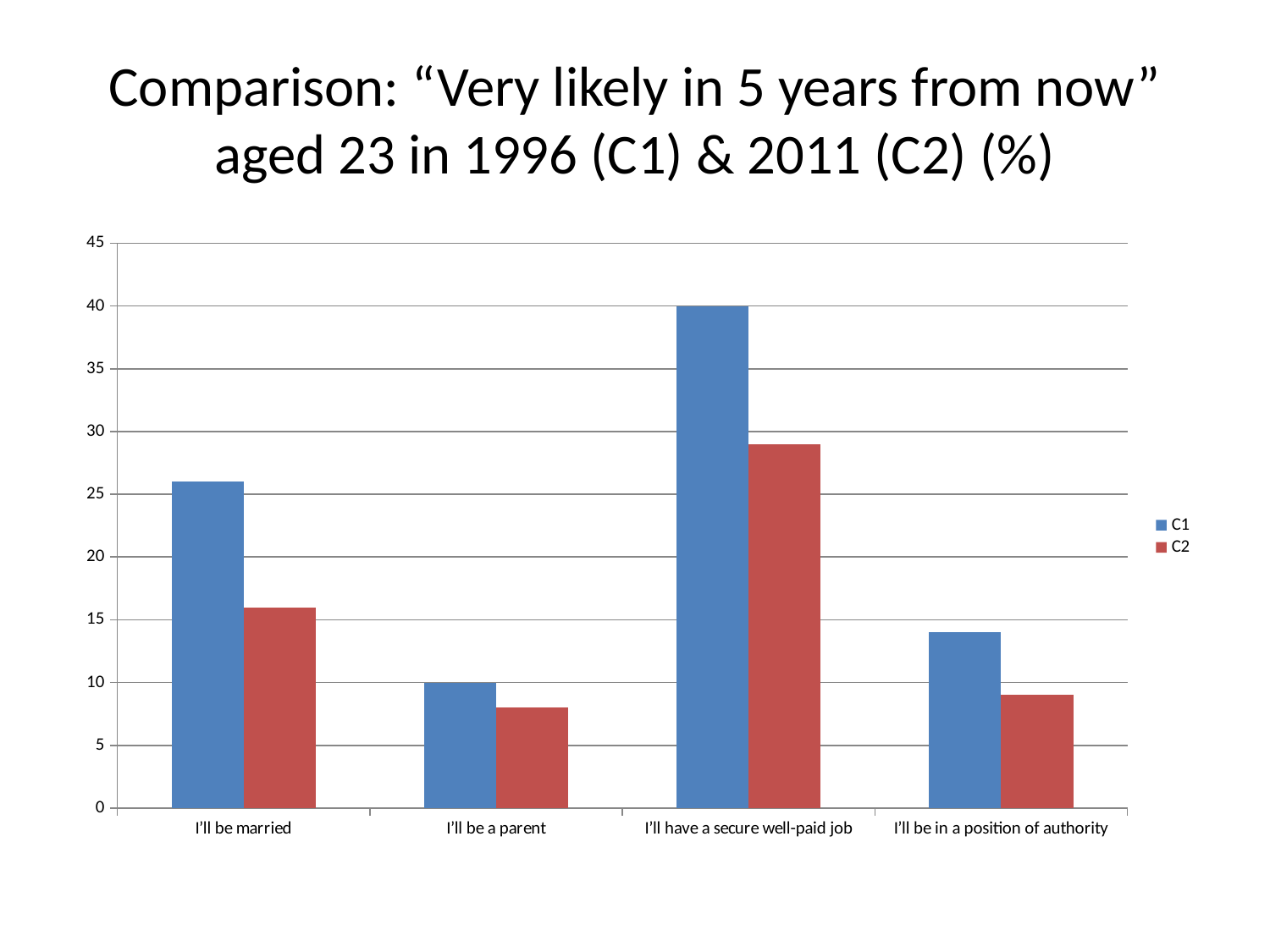
Which category has the highest C1 value? I'll have a secure well-paid job What is the C1 value for "I'll be a parent"? 10 How many categories are shown on the x axis? 4 How many series does the legend list? 2 What kind of chart is shown on the slide? bar chart Is the C1 value for "I'll be married" greater or less than 25? greater Which series is shown in red? C2 Is the C2 value for "I'll be in a position of authority" greater or less than 10? less Is the C2 value for "I'll have a secure well-paid job" greater or less than 30? less What is the C1 value for "I'll have a secure well-paid job"? 40 For "I'll be married", which series has the larger value, C1 or C2? C1 Which category has the lowest C2 value? I'll be a parent